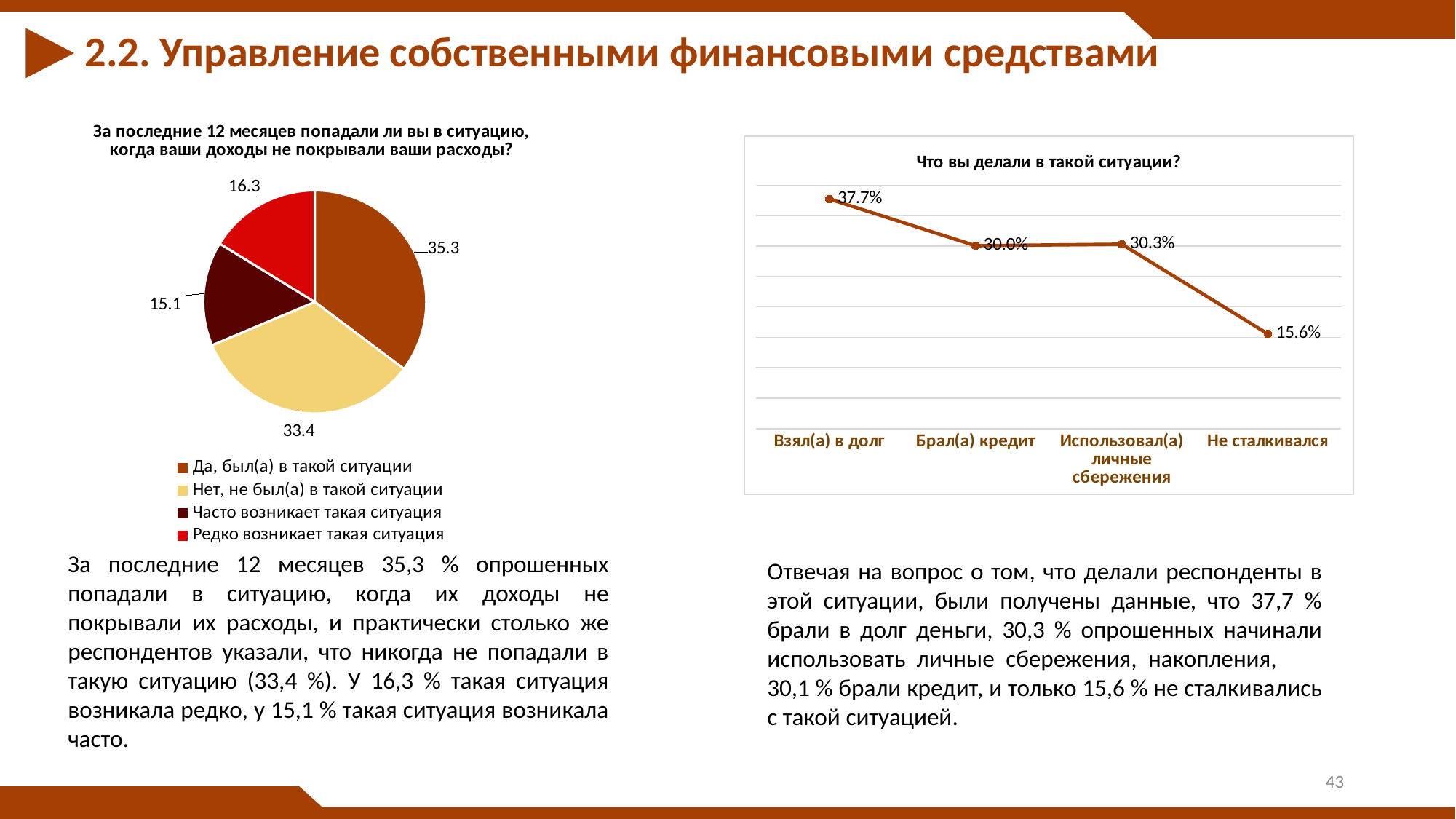
In the chart "Что вы делали в такой ситуации?", what is the value for "Взял(а) в долг"? 37.7% In the chart "Что вы делали в такой ситуации?", what is the difference between "Взял(а) в долг" and "Не сталкивался"? 22.1% How many categories does the legend of the pie chart on the left list? 4 In the pie chart on the left, which category has the smallest slice? Часто возникает такая ситуация In the pie chart on the left, what is the value for "Редко возникает такая ситуация"? 16.3 In the pie chart on the left, what is the value for "Да, был(а) в такой ситуации"? 35.3 What type of chart is the chart "Что вы делали в такой ситуации?"? line chart In the chart "Что вы делали в такой ситуации?", which category has the highest value? Взял(а) в долг In the pie chart on the left, which category has the largest slice? Да, был(а) в такой ситуации In the pie chart on the left, what is the difference between "Да, был(а) в такой ситуации" and "Нет, не был(а) в такой ситуации"? 1.9 In the chart "Что вы делали в такой ситуации?", what is the value for "Не сталкивался"? 15.6% What type of chart is the chart on the left? pie chart